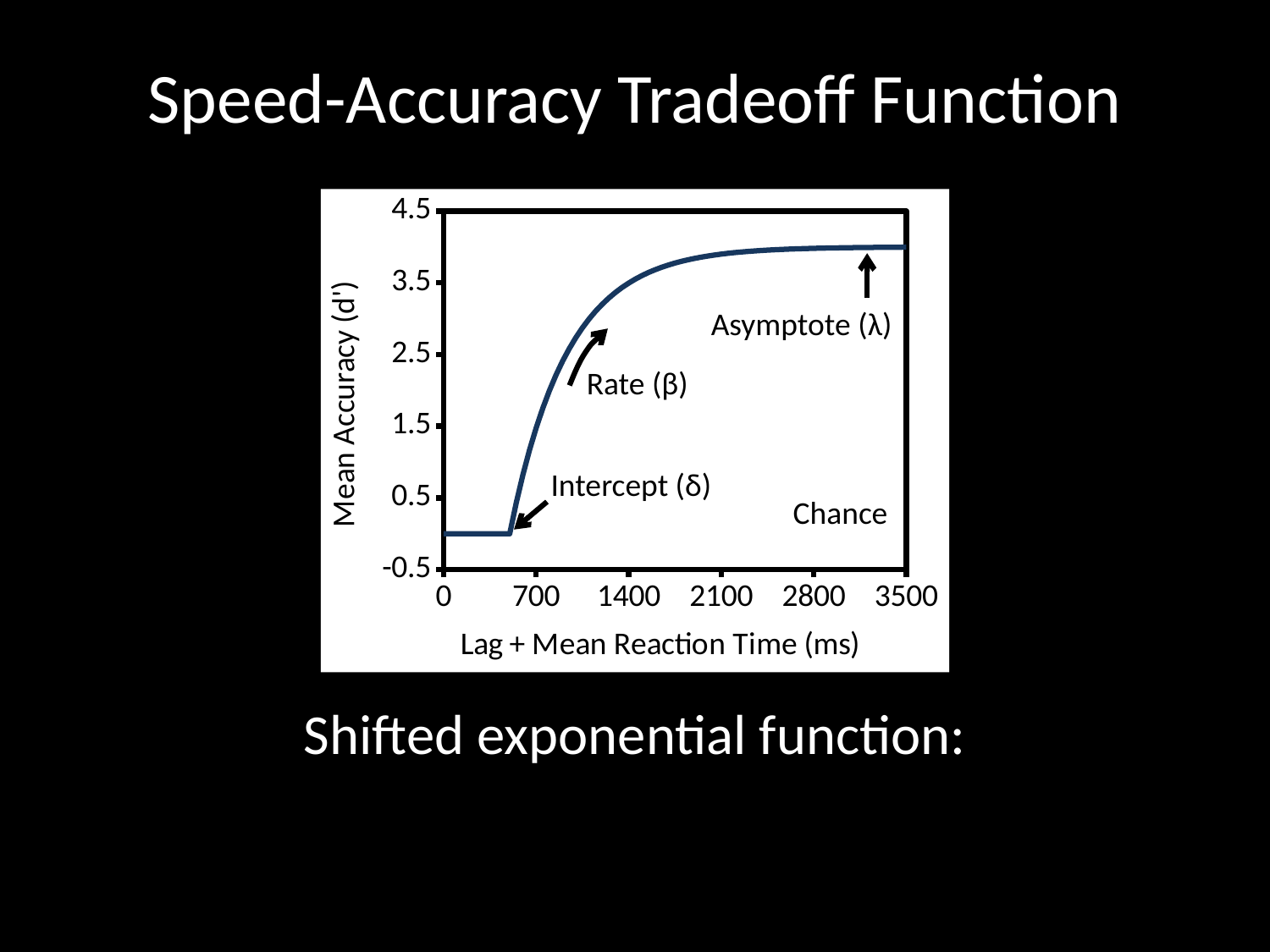
What kind of chart is shown on the slide? line chart What is the label of the y axis? Mean Accuracy (d') Is the value of the curve at 2100 ms greater or less than 3.5? greater What is the title of the slide containing the chart? Speed-Accuracy Tradeoff Function Is the value of the curve at 3500 ms greater or less than 3.5? greater Which of the two points, 700 ms or 2800 ms, has the larger value on the curve? 2800 ms Is the value of the curve at 0 ms greater or less than 0.5? less What is the lowest tick value shown on the y axis? -0.5 Does the plotted curve rise or fall as Lag + Mean Reaction Time increases beyond the intercept? rise What is the highest tick value shown on the x axis? 3500